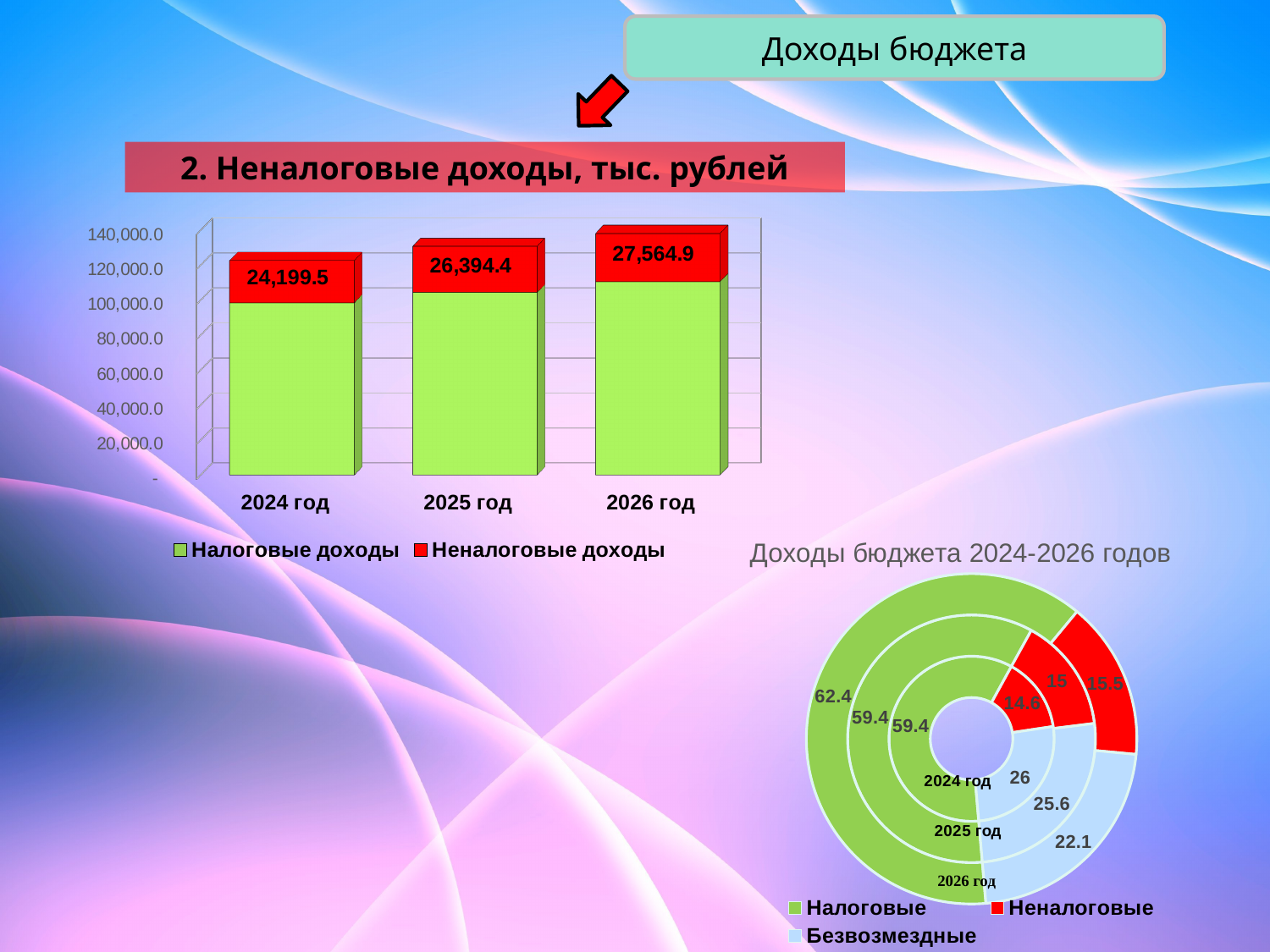
In the bar chart titled '2. Неналоговые доходы, тыс. рублей', how many years are shown on the x axis? 3 In the chart titled 'Доходы бюджета 2024-2026 годов', what is the value of Неналоговые for 2026 год? 15.5 In the bar chart titled '2. Неналоговые доходы, тыс. рублей', by how much does Неналоговые доходы in 2026 год exceed that in 2024 год? 3,365.4 In the bar chart titled '2. Неналоговые доходы, тыс. рублей', how many series does the legend list? 2 What kind of chart is the chart titled 'Доходы бюджета 2024-2026 годов'? doughnut chart In the bar chart titled '2. Неналоговые доходы, тыс. рублей', do the Неналоговые доходы values rise or fall from 2024 год to 2026 год? rise In the bar chart titled '2. Неналоговые доходы, тыс. рублей', is the value of Налоговые доходы for 2024 год greater or less than 80,000.0? greater In the bar chart titled '2. Неналоговые доходы, тыс. рублей', what is the value of Неналоговые доходы for 2024 год? 24,199.5 In the chart titled 'Доходы бюджета 2024-2026 годов', what is the value of Безвозмездные for 2024 год? 26 In the chart titled 'Доходы бюджета 2024-2026 годов', how many categories does the legend list? 3 In the bar chart titled '2. Неналоговые доходы, тыс. рублей', which year has the highest Неналоговые доходы? 2026 год In the bar chart titled '2. Неналоговые доходы, тыс. рублей', what is the value of Неналоговые доходы for 2026 год? 27,564.9